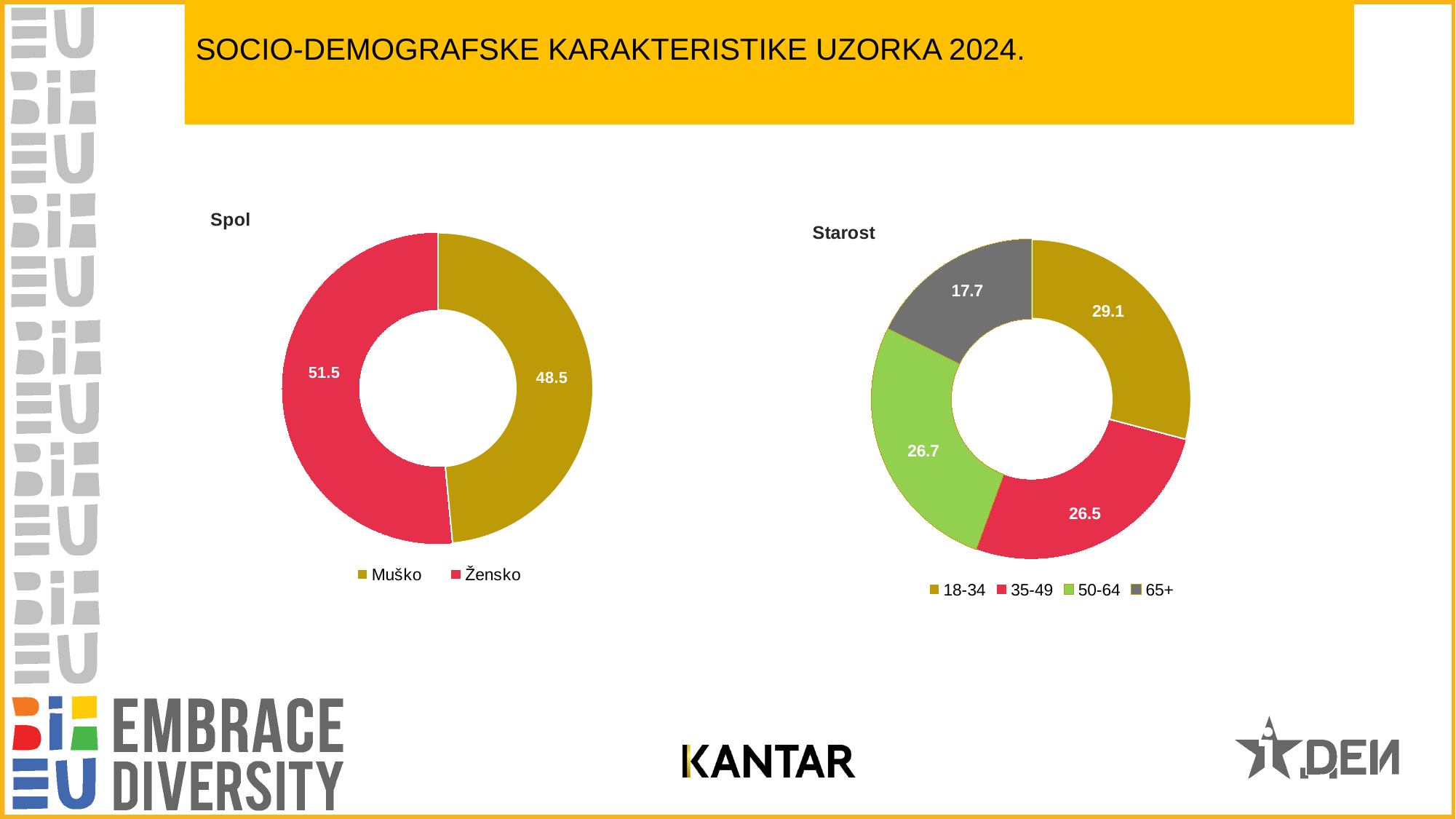
In the Starost chart, what is the value for the 35-49 group? 26.5 What kind of chart is the Spol chart? Pie chart (donut) In the Spol chart, what is the value for Žensko? 51.5 In the Spol chart, which is larger, Muško or Žensko? Žensko In the Starost chart, what is the value for the 65+ group? 17.7 In the Starost chart, which age group has the largest share? 18-34 In the Spol chart, what is the difference between Žensko and Muško? 3 In the Starost chart, what is the value for the 18-34 group? 29.1 In the Starost chart, what is the difference between the 18-34 group and the 65+ group? 11.4 In the Spol chart, what is the value for Muško? 48.5 How many categories does the Starost chart show? 4 In the Starost chart, which age group has the smallest share? 65+